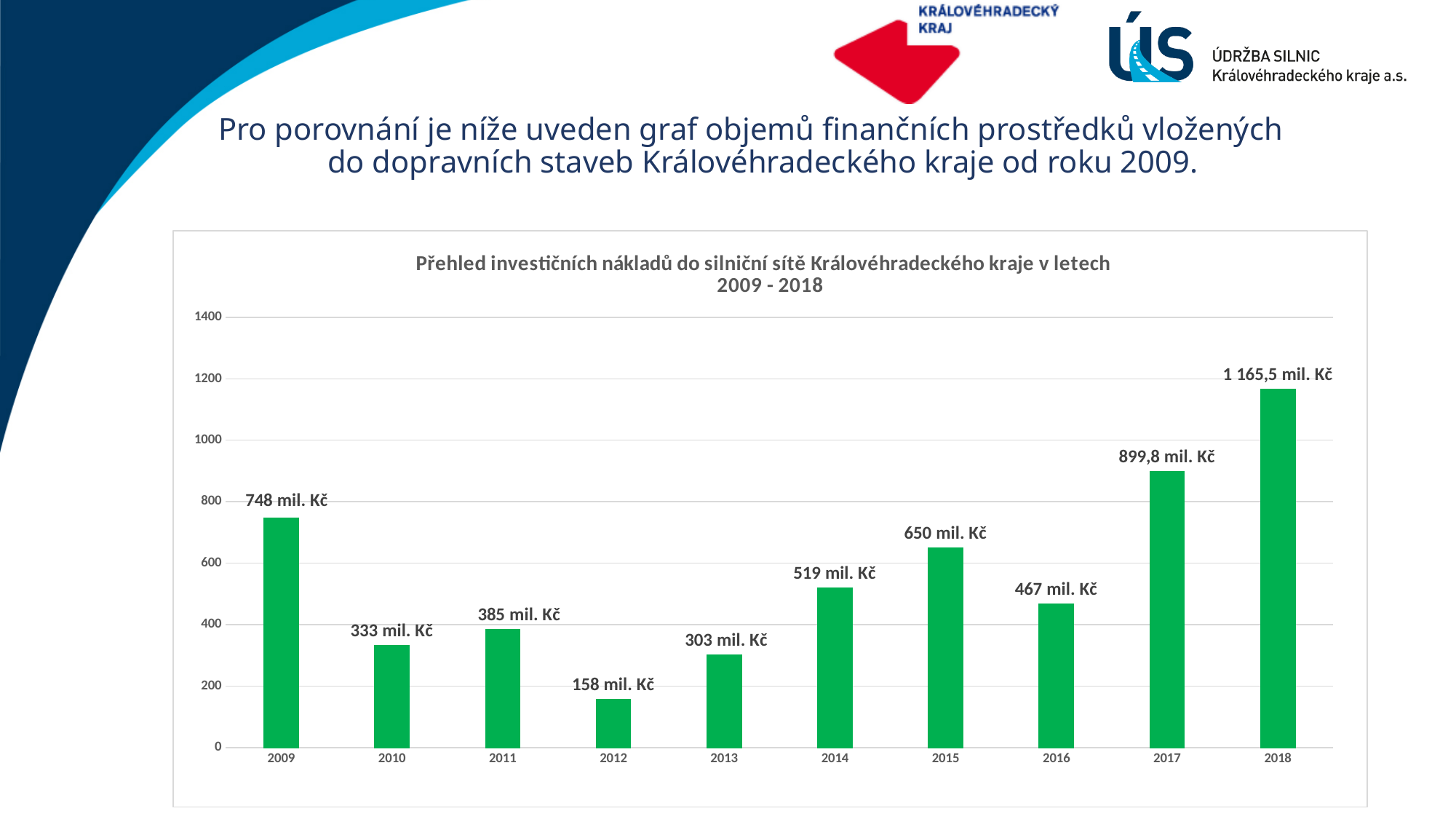
What is the value for 2017? 899,8 mil. Kč Which year has the highest value? 2018 What kind of chart is shown? bar chart What is the difference between the values for 2015 and 2016? 183 mil. Kč What is the title of the chart? Přehled investičních nákladů do silniční sítě Královéhradeckého kraje v letech 2009 - 2018 What is the value for 2012? 158 mil. Kč How many years are shown on the x axis? 10 Which year has the lowest value? 2012 Which is larger, the value for 2011 or the value for 2013? 2011 Is the value for 2014 greater or less than 400? greater Do the values rise or fall from 2016 to 2018? rise What is the value for 2009? 748 mil. Kč